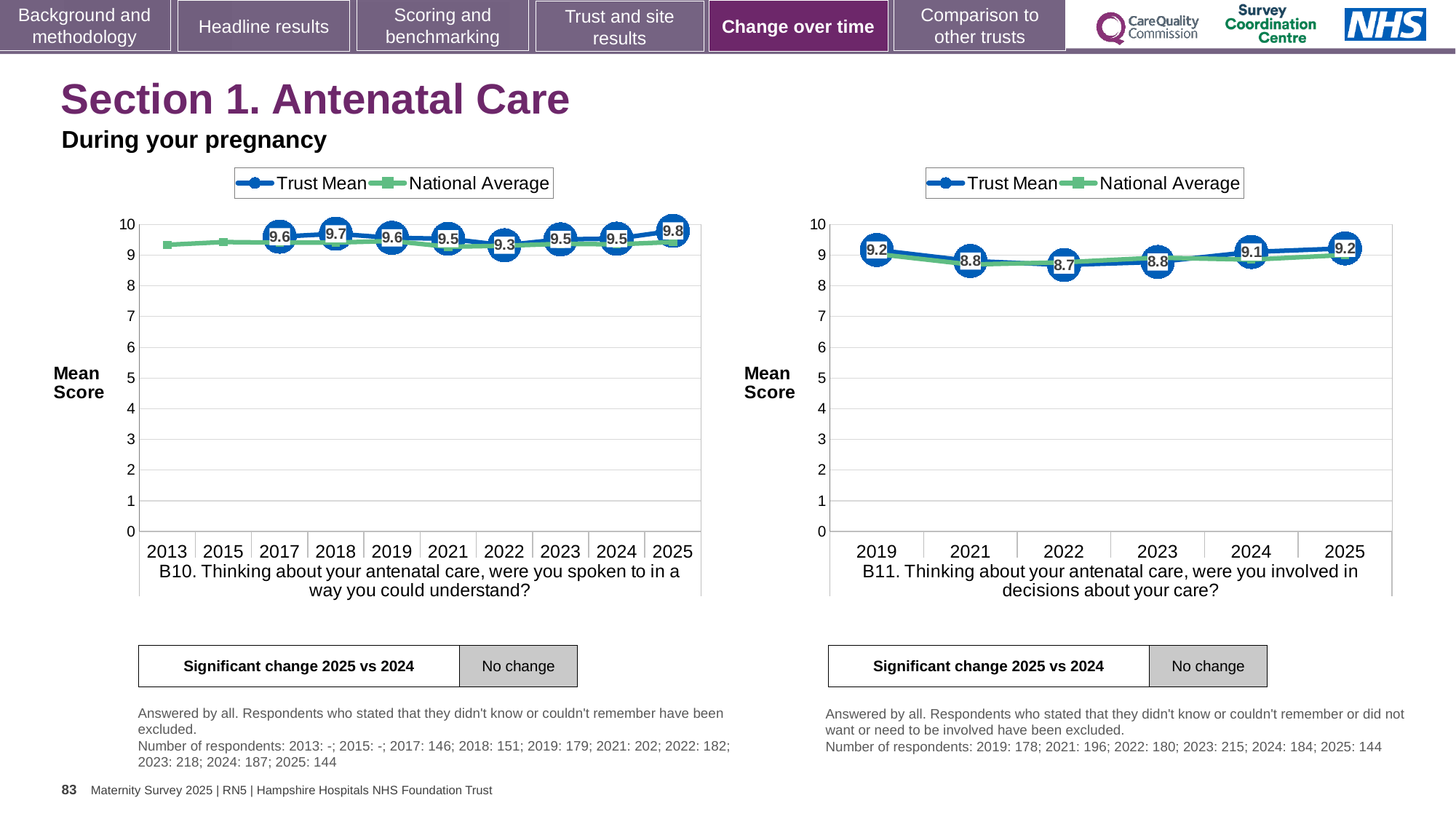
In the B10 chart (left), what is the Trust Mean for 2022? 9.3 In the B10 chart (left), what is the Trust Mean for 2025? 9.8 In the B10 chart (left), how many years are shown on the x axis? 10 In the B10 chart (left), which year has the highest Trust Mean? 2025 In the B11 chart (right), is the Trust Mean for 2019 larger or smaller than the Trust Mean for 2021? larger In the B11 chart (right), what is the Trust Mean for 2024? 9.1 What kind of chart is the B11 chart (right)? Line chart In the B11 chart (right), what is the Trust Mean for 2022? 8.7 In the B10 chart (left), which year has the lowest labelled Trust Mean? 2022 In the B11 chart (right), how many series does the legend list? 2 In the B10 chart (left), what is the difference between the Trust Mean for 2025 and 2024? 0.3 In the B11 chart (right), which year has the lowest Trust Mean? 2022